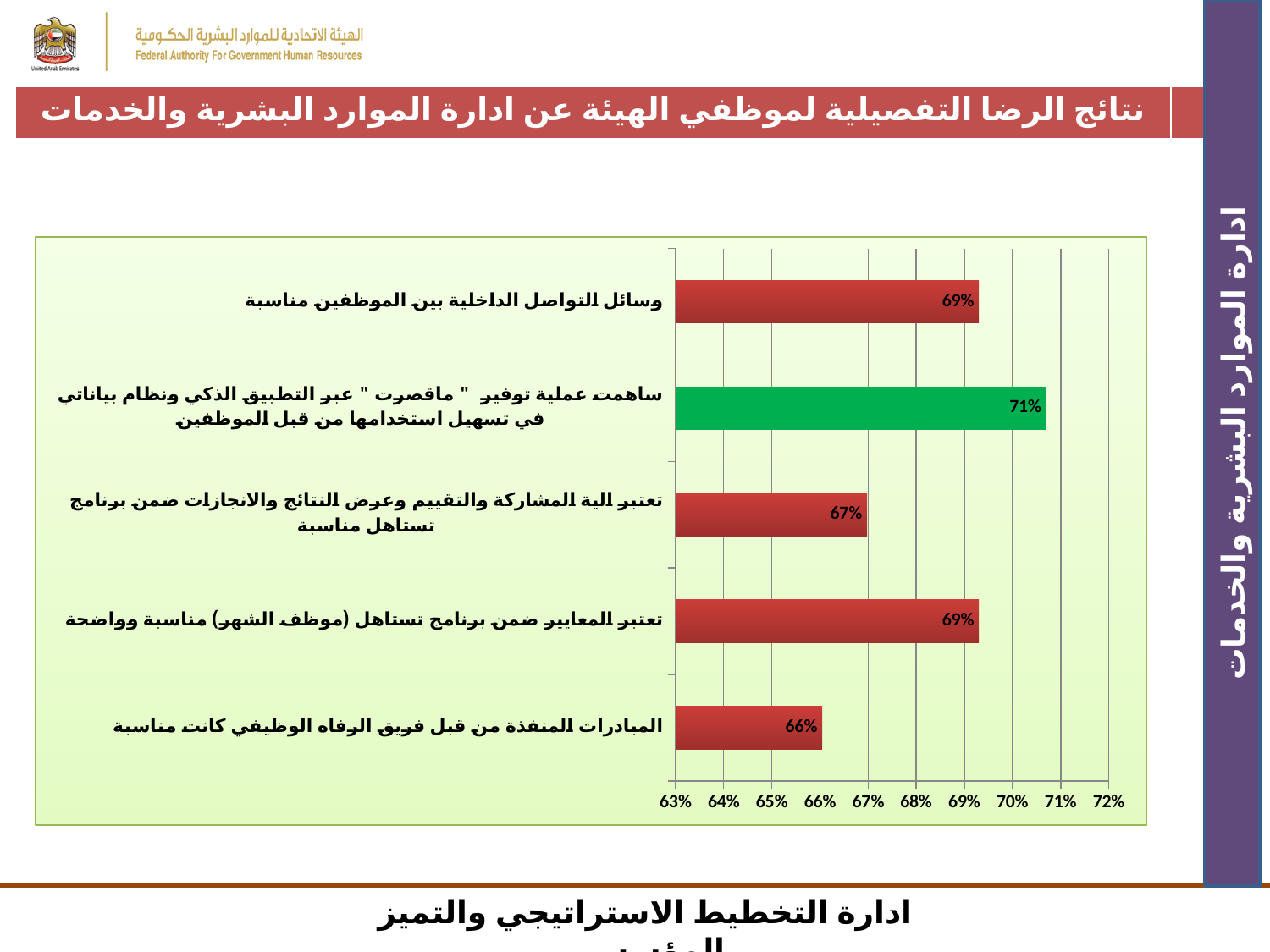
Is the value for "المبادرات المنفذة من قبل فريق الرفاه الوظيفي كانت مناسبة" greater or less than 68%? less Which is larger: the value for "تعتبر المعايير ضمن برنامج تستاهل (موظف الشهر) مناسبة وواضحة" or the value for "تعتبر الية المشاركة والتقييم وعرض النتائج والانجازات ضمن برنامج تستاهل مناسبة"? تعتبر المعايير ضمن برنامج تستاهل (موظف الشهر) مناسبة وواضحة What type of chart is shown on the slide? bar chart What is the value for the bottom bar, "المبادرات المنفذة من قبل فريق الرفاه الوظيفي كانت مناسبة"? 66% What is the difference between the highest value (71%) and the lowest value (66%)? 5% What is the value for the bar "ساهمت عملية توفير "ماقصرت" عبر التطبيق الذكي ونظام بياناتي في تسهيل استخدامها من قبل الموظفين"? 71% How many categories (bars) does the chart show? 5 What is the value for the bar "تعتبر الية المشاركة والتقييم وعرض النتائج والانجازات ضمن برنامج تستاهل مناسبة"? 67% Which category has the lowest value? المبادرات المنفذة من قبل فريق الرفاه الوظيفي كانت مناسبة What is the value for the top bar, "وسائل التواصل الداخلية بين الموظفين مناسبة"? 69% Which category has the highest value? ساهمت عملية توفير "ماقصرت" عبر التطبيق الذكي ونظام بياناتي في تسهيل استخدامها من قبل الموظفين What colour is the bar with the highest value? green